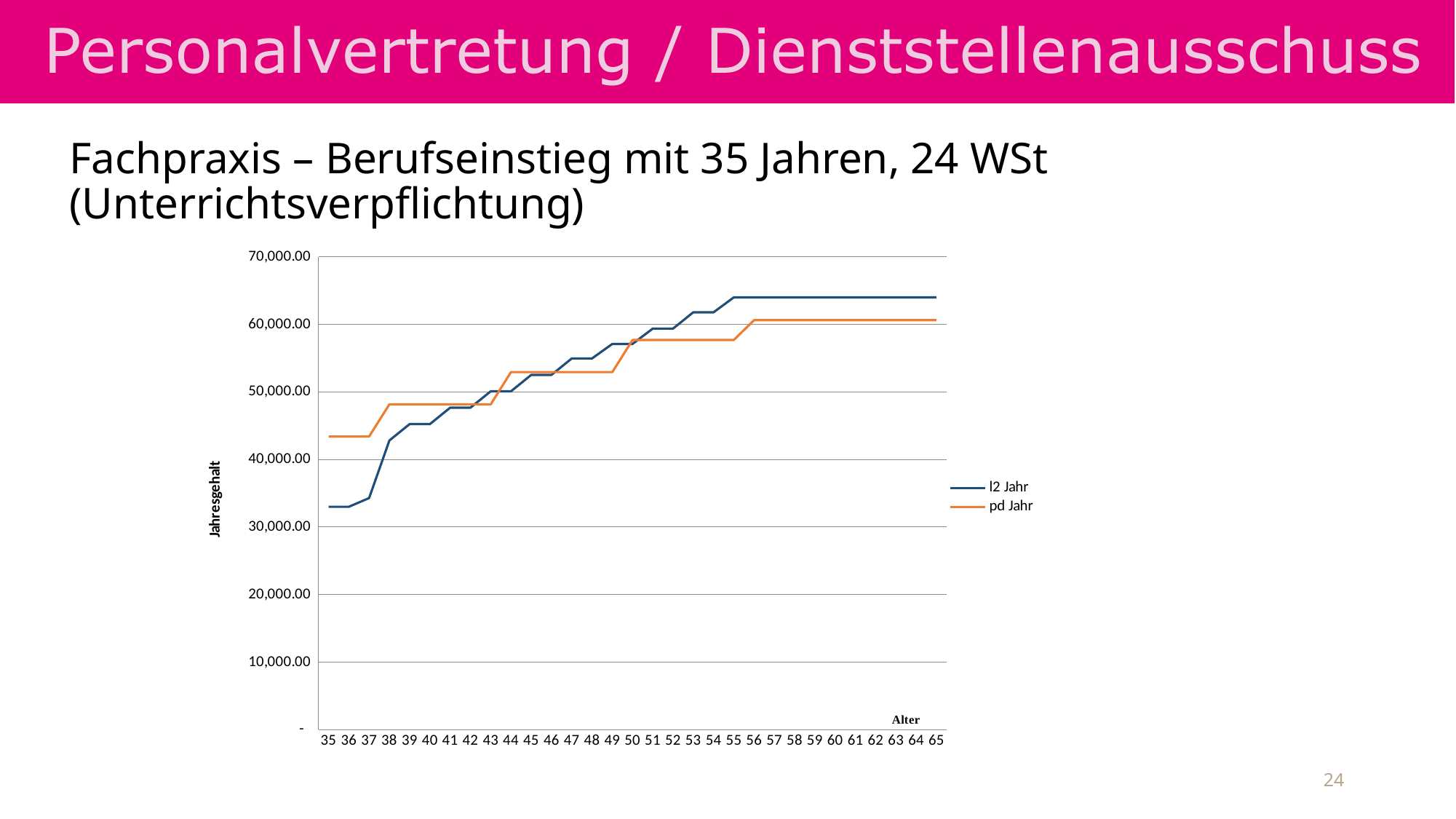
How many series does the chart legend list? 2 What are the two series named in the chart legend? l2 Jahr and pd Jahr Do the values for l2 Jahr generally rise or fall as age increases from 35 to 65? rise What kind of chart is shown on the slide? line chart Is the value for l2 Jahr at age 35 greater or less than 40,000.00? less Is the value for l2 Jahr at age 65 greater or less than 60,000.00? greater At age 35, which series has the higher value, l2 Jahr or pd Jahr? pd Jahr Is the value for pd Jahr at age 35 greater or less than 40,000.00? greater What is the label of the vertical axis of the chart? Jahresgehalt How many age values are shown along the x axis of the chart? 31 At age 65, which series has the higher value, l2 Jahr or pd Jahr? l2 Jahr